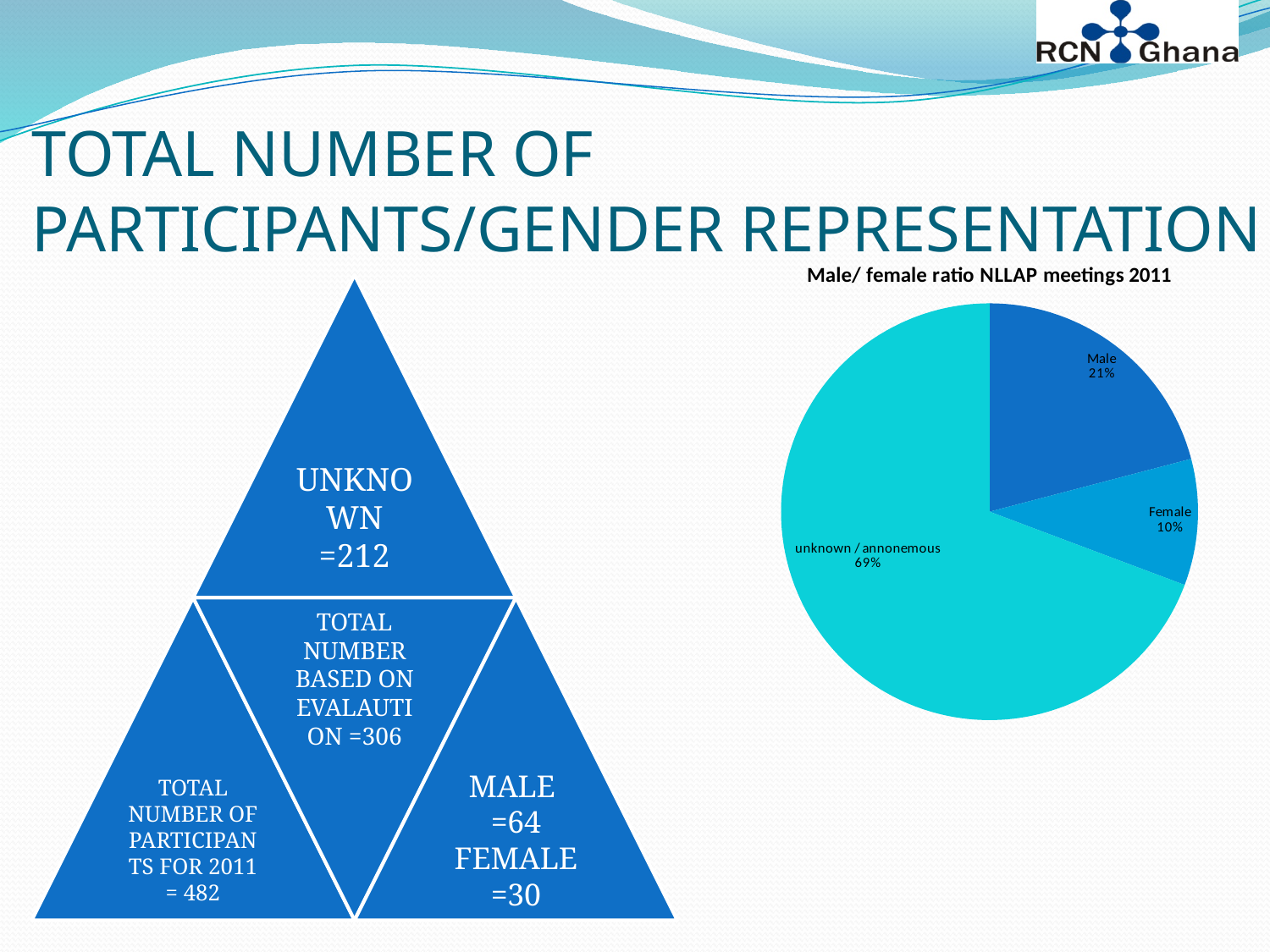
What kind of chart is shown on the slide? pie chart What share of the pie chart is labelled Male? 21% By how many percentage points does the unknown / annonemous share exceed the Male share in the pie chart? 48 Which slice of the pie chart is the smallest? Female Which is larger in the pie chart, the Male slice or the Female slice? Male By how many percentage points does the Male share exceed the Female share in the pie chart? 11 Which slice of the pie chart is the largest? unknown / annonemous What is the title of the pie chart? Male/ female ratio NLLAP meetings 2011 What share of the pie chart is labelled Female? 10% How many slices does the pie chart have? 3 What share of the pie chart is labelled unknown / annonemous? 69% What is the combined share of the Male and Female slices in the pie chart? 31%